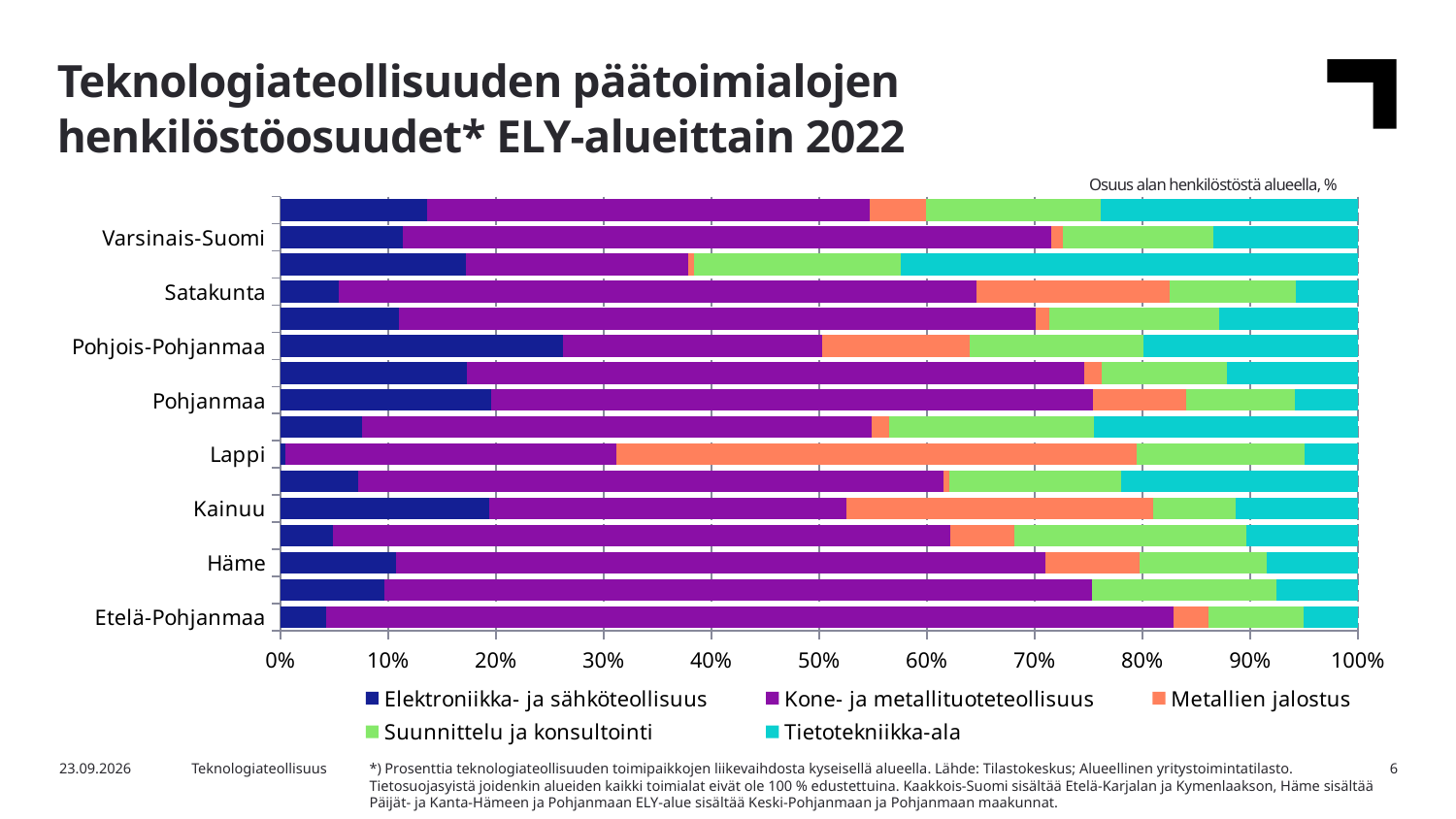
Is the value for Metallien jalostus in Satakunta greater or less than 10%? greater Is the value for Kone- ja metallituoteteollisuus in Etelä-Pohjanmaa greater or less than 70%? greater Is the value for Elektroniikka- ja sähköteollisuus in Pohjois-Pohjanmaa greater or less than 20%? greater What unit note is shown above the chart? Osuus alan henkilöstöstä alueella, % Which is larger: the Elektroniikka- ja sähköteollisuus share in Pohjois-Pohjanmaa or in Etelä-Pohjanmaa? Pohjois-Pohjanmaa Which region has the largest share for Metallien jalostus? Lappi What kind of chart is shown on the slide? Stacked bar chart How many series does the legend list? 5